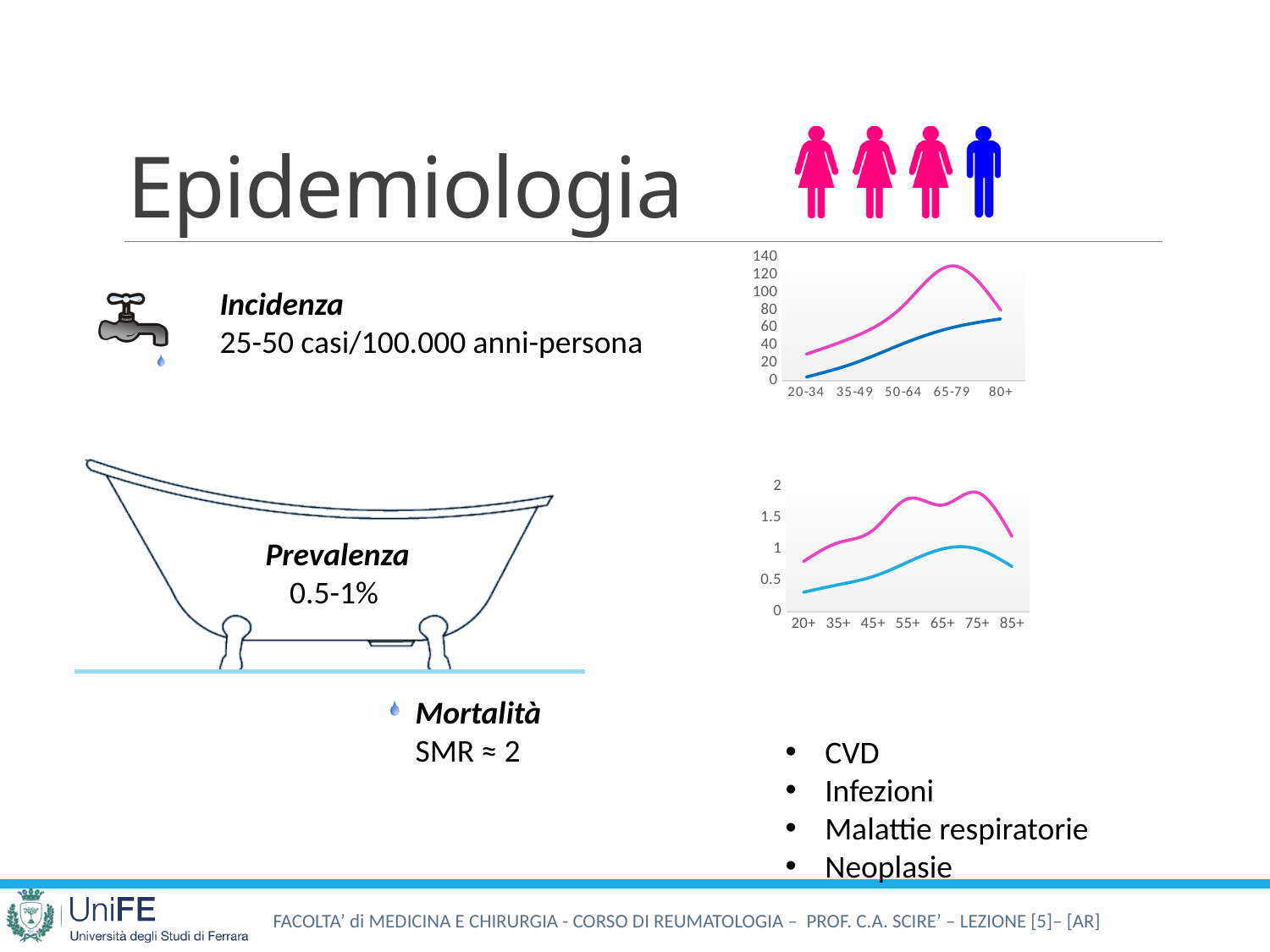
In the upper chart, is the value of the pink line at 65-79 greater or less than 100? greater In the upper chart, is the value of the blue line at 20-34 greater or less than 20? less In the upper chart, how many age categories are shown on the x axis? 5 In the lower chart, is the value of the blue line at 20+ greater or less than 0.5? less In the upper chart, how many lines are plotted? 2 In the upper chart, at 65-79, which line has the larger value, the pink line or the blue line? pink line In the upper chart, does the blue line rise or fall from 20-34 to 80+? rise What kind of chart is the upper chart on the right of the slide? line chart What kind of chart is the lower chart on the right of the slide? line chart In the lower chart, how many age categories are shown on the x axis? 7 In the upper chart, at which age category does the pink line reach its highest value? 65-79